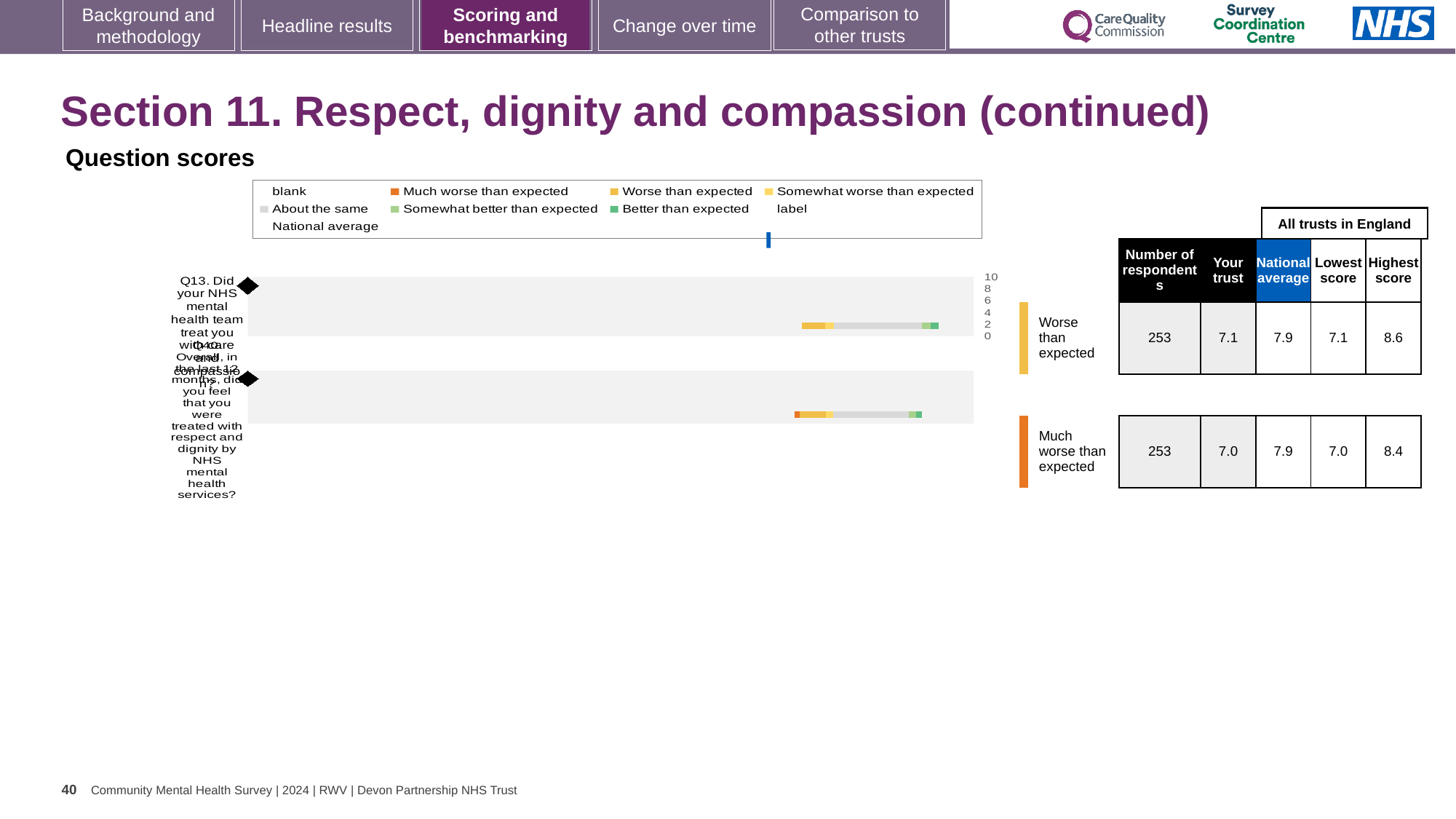
What is the lowest score among all trusts in England for Q14? 7.0 How many questions are plotted in the question scores chart? 2 Which question has the higher 'Your trust' score, Q13 or Q14? Q13 Which benchmark category is shown for Q13? Worse than expected What is the 'Your trust' score for Q13 in the table? 7.1 What is the difference between the highest and lowest scores for Q13? 1.5 By how much is the national average higher than the trust's score for Q14? 0.9 How many respondents answered Q13? 253 What is the national average score for Q14? 7.9 What kind of chart is used to show the question scores on this slide? bar chart Which benchmark category is shown for Q14? Much worse than expected What is the highest score among all trusts in England for Q13? 8.6